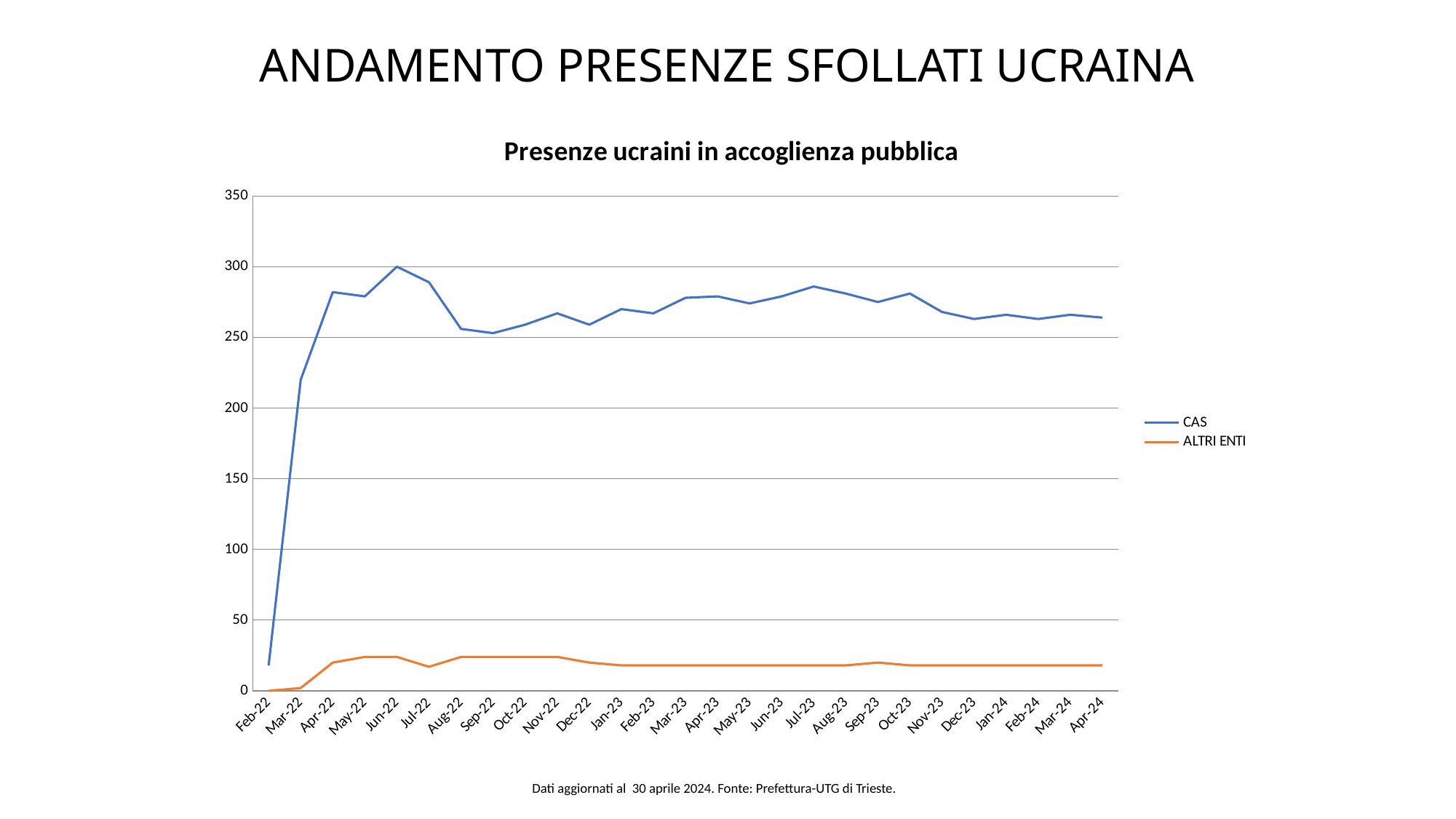
What kind of chart is shown on the slide? line chart How many series does the legend list? 2 Is the CAS value for Jun-22 greater or less than 250? greater Is the CAS value for Mar-22 greater or less than 200? greater Is the CAS value for Feb-22 greater or less than 50? less In which month does the CAS series reach its highest value? Jun-22 What is the title of the chart? Presenze ucraini in accoglienza pubblica Which series has the larger value in Apr-24, CAS or ALTRI ENTI? CAS How many months are shown along the x axis? 27 In which month is the CAS series at its lowest value? Feb-22 Does the CAS series rise or fall between Feb-22 and Jun-22? rise